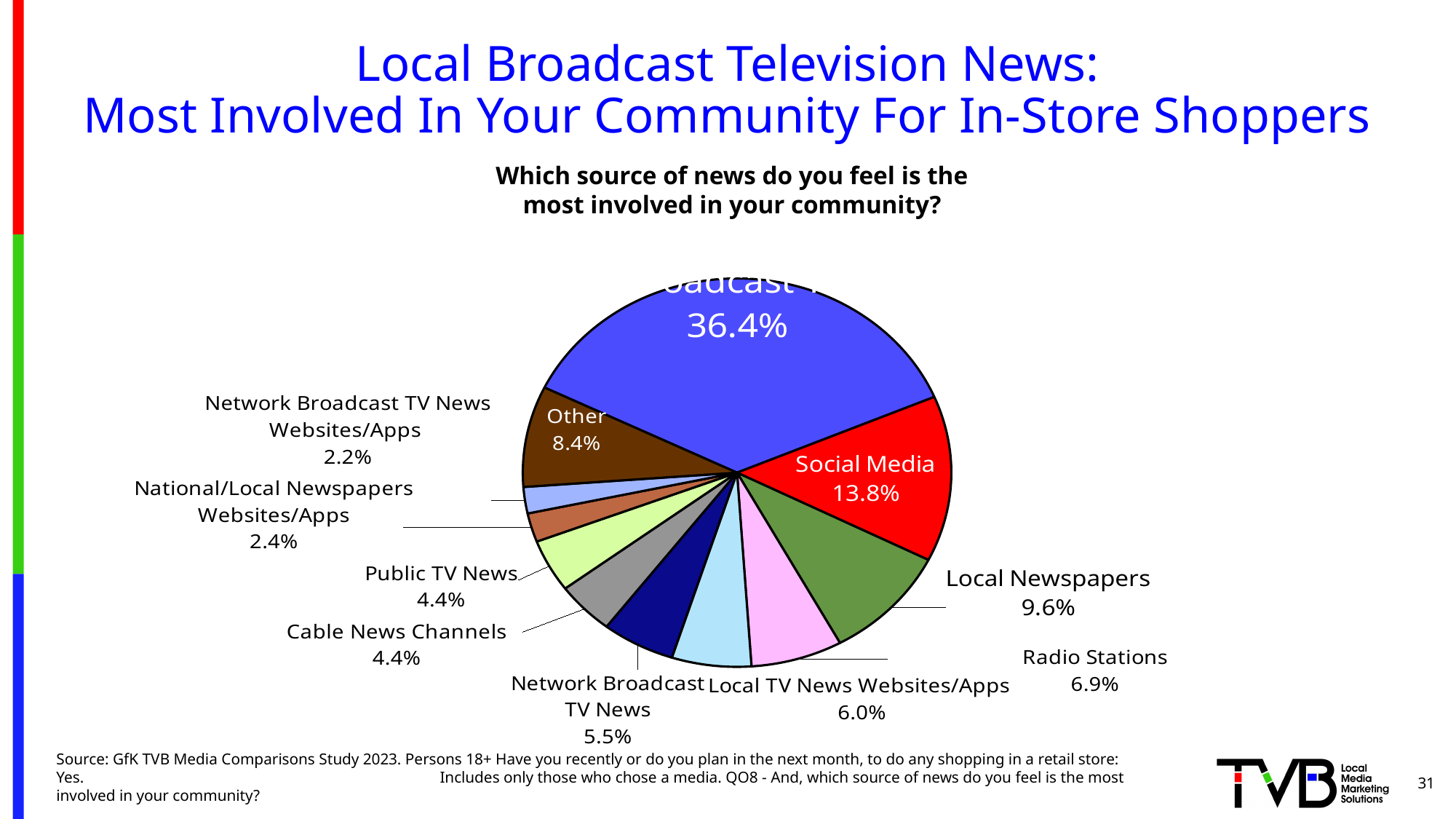
What question is shown as the subtitle above the pie chart? Which source of news do you feel is the most involved in your community? What is the value for Local TV News Websites/Apps? 6.0% What is the difference between the Social Media and Local Newspapers values? 4.2% What is the value of the largest slice in the pie chart? 36.4% Which category has the smallest slice in the pie chart? Network Broadcast TV News Websites/Apps What is the value shown for Local Newspapers? 9.6% What share is shown for Radio Stations? 6.9% What percentage of respondents chose Social Media as the source most involved in their community? 13.8% Which is larger, Network Broadcast TV News or Cable News Channels? Network Broadcast TV News What kind of chart is shown on the slide? pie chart What percentage is shown for the Other slice? 8.4% How many slices does the pie chart have? 11